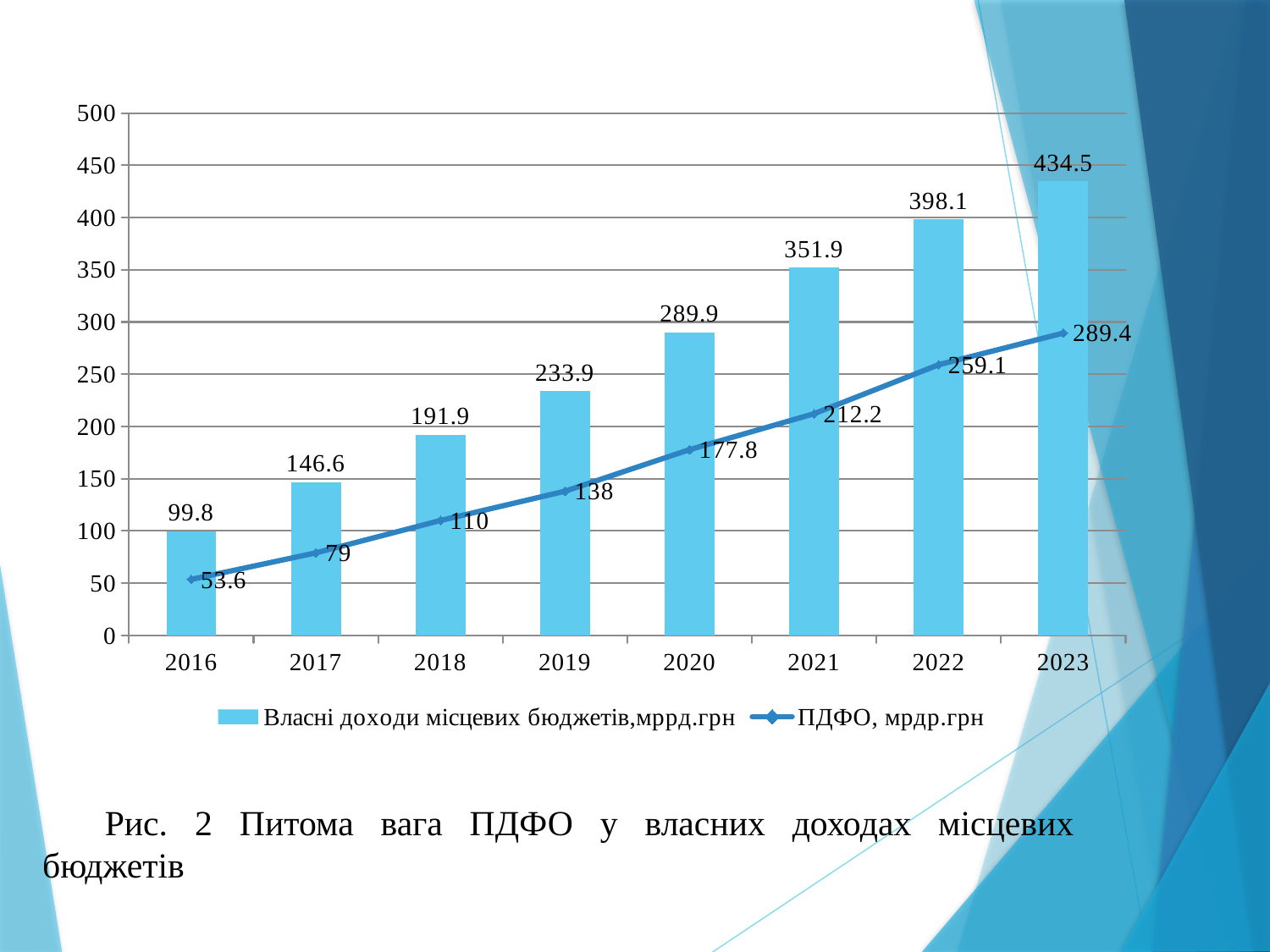
Do the ПДФО values rise or fall from 2016 to 2023? rise What is the difference between Власні доходи місцевих бюджетів in 2023 and in 2022? 36.4 Which year has the highest value of Власні доходи місцевих бюджетів? 2023 Which series is drawn as a line with markers? ПДФО, мрдр.грн What is the ПДФО value for 2018? 110 What is the value of Власні доходи місцевих бюджетів for 2020? 289.9 Which year has the lowest ПДФО value? 2016 What is the ПДФО value for 2023? 289.4 How many series does the legend list? 2 What is the difference between the Власні доходи місцевих бюджетів value and the ПДФО value in 2021? 139.7 How many years are shown on the x axis? 8 Which is larger: the ПДФО value in 2022 or the Власні доходи місцевих бюджетів value in 2019? ПДФО value in 2022